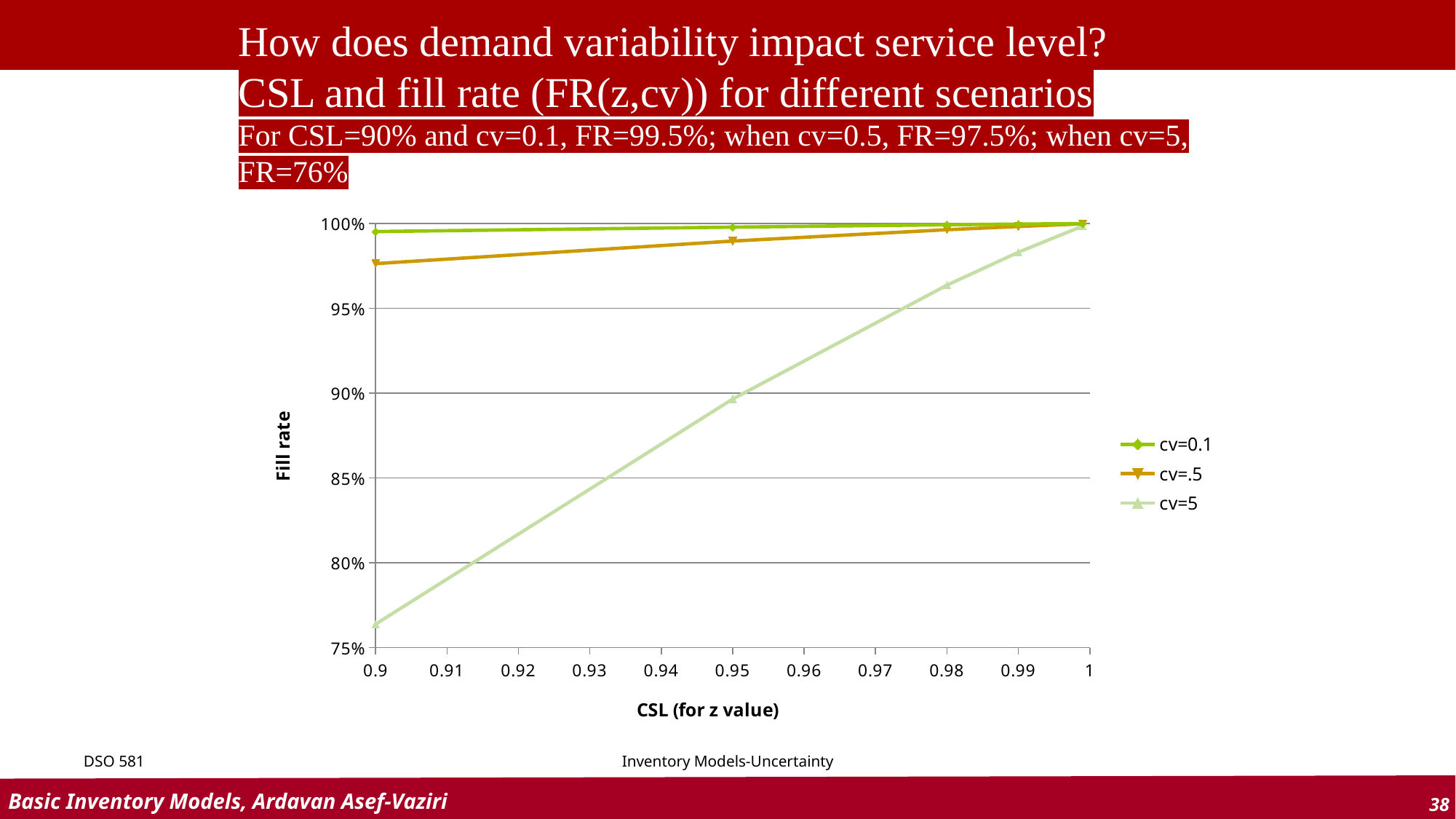
What are the three series named in the chart's legend? cv=0.1, cv=.5, cv=5 According to the slide, what is the fill rate for cv=5 when CSL = 90%? 76% How many data points are plotted for each series along the CSL axis? 5 What kind of chart is shown on the slide? line chart What is the title of the chart's x axis? CSL (for z value) How many series does the chart's legend list? 3 Is the fill rate for the cv=5 series at CSL = 0.98 greater or less than 95%? greater Which series has the highest fill rate at CSL = 0.9? cv=0.1 Is the fill rate for the cv=5 series at CSL = 0.9 greater or less than 80%? less Does the fill rate for the cv=5 series rise or fall as CSL increases from 0.9 to 1? rise At CSL = 0.95, which series has the larger fill rate, cv=.5 or cv=5? cv=.5 Which series has the lowest fill rate at CSL = 0.9? cv=5